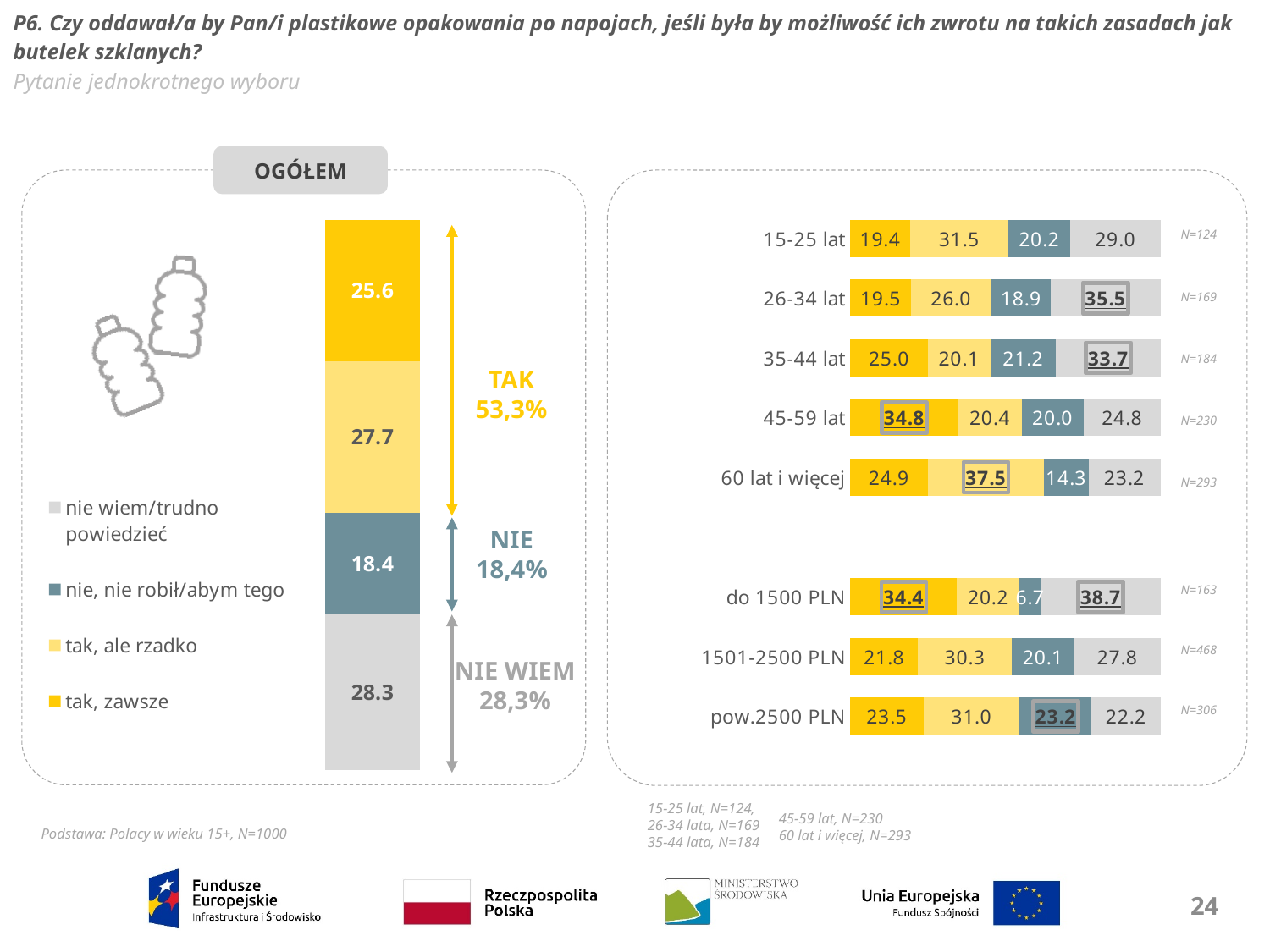
In the right-hand chart, what is the "nie, nie robił/abym tego" value for do 1500 PLN? 6.7 In the OGÓŁEM chart, what is the value for "nie wiem/trudno powiedzieć"? 28.3 In the right-hand chart, which group has the larger "nie wiem/trudno powiedzieć" value: 26-34 lat or 35-44 lat? 26-34 lat In the OGÓŁEM chart, which response category has the largest segment? nie wiem/trudno powiedzieć How many series does the legend of the OGÓŁEM chart list? 4 In the right-hand chart, what is the difference between the "tak, ale rzadko" and "tak, zawsze" values for 15-25 lat? 12.1 In the right-hand chart by age and income, what is the "tak, zawsze" value for 45-59 lat? 34.8 What kind of chart is the OGÓŁEM chart on the left? Stacked bar chart How many groups (bars) are shown in the right-hand chart? 8 In the OGÓŁEM chart, what is the value for "tak, zawsze"? 25.6 In the OGÓŁEM chart, what is the combined share labelled TAK? 53,3% In the right-hand chart, which age group has the highest "tak, ale rzadko" value? 60 lat i więcej